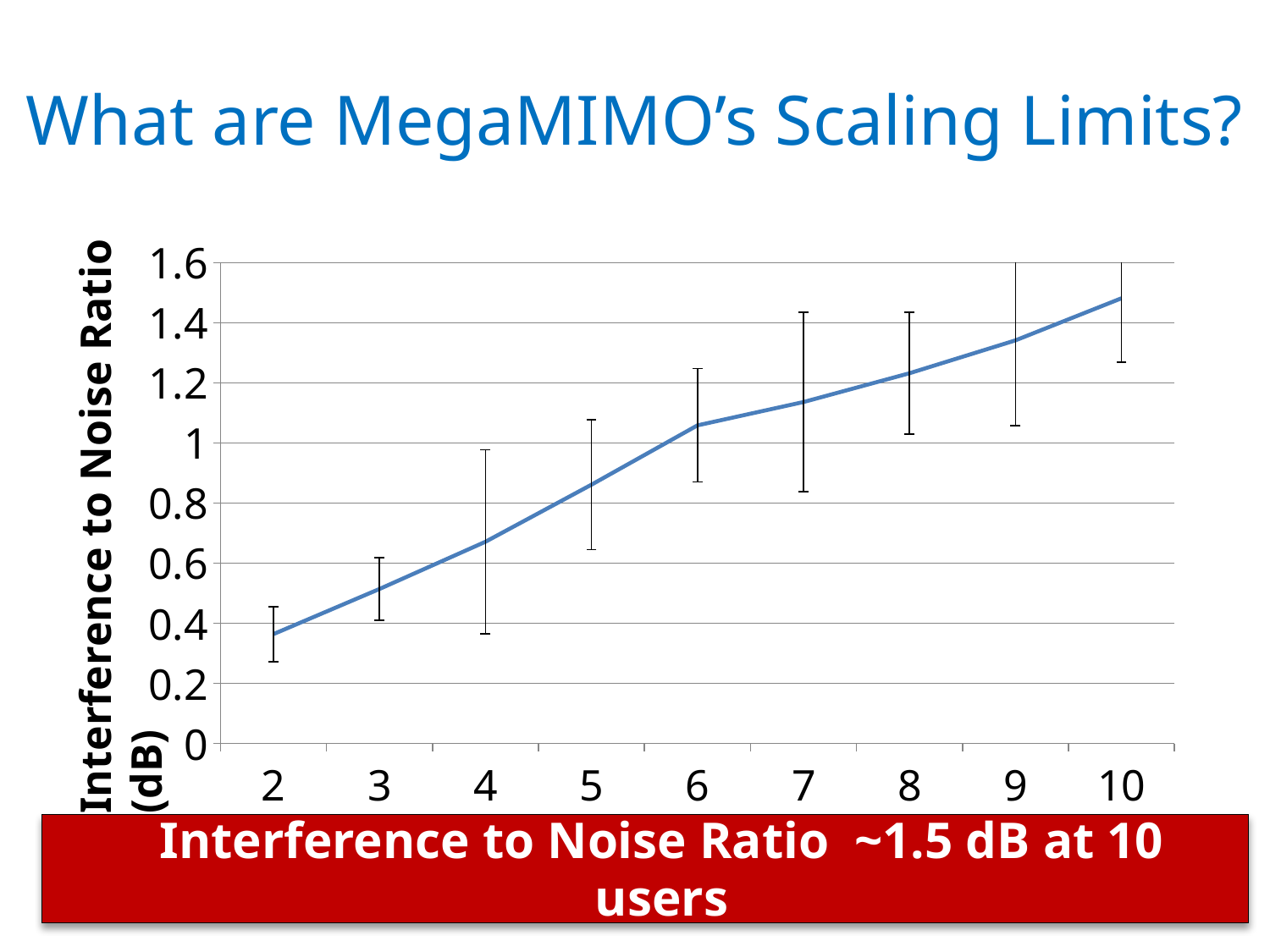
Is the value at 2 greater or less than 0.6? less At which x-axis value is the Interference to Noise Ratio lowest? 2 What kind of chart is shown on the slide? line chart Does the Interference to Noise Ratio rise or fall as the number of users increases from 2 to 10? rise At which x-axis value is the Interference to Noise Ratio highest? 10 Is the value at 5 greater or less than 1? less How many data points are plotted along the x axis? 9 Is the value at 7 greater or less than 1? greater Which has the larger Interference to Noise Ratio, 3 or 8? 8 What is the label of the y axis? Interference to Noise Ratio (dB) What is the title of the slide? What are MegaMIMO's Scaling Limits?